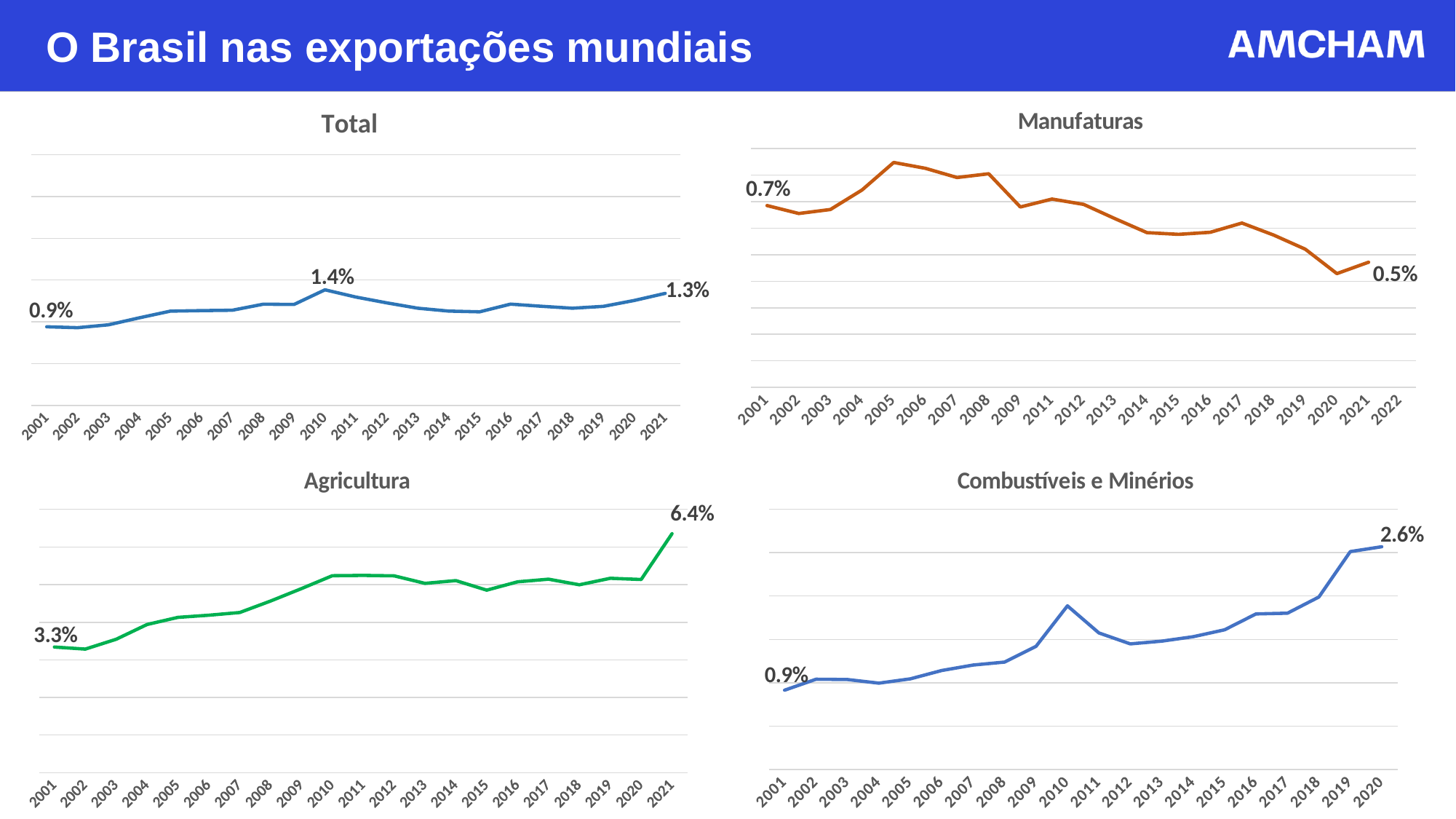
In the Manufaturas chart, does the value overall rise or fall from 2001 to 2021? fall In the Manufaturas chart, which year has the lowest value? 2020 In the Combustíveis e Minérios chart, which is larger, the 2001 value or the 2020 value? 2020 In the Agricultura chart, what is the difference between the 2021 value and the 2001 value? 3.1 percentage points In the Total chart, what value is labelled for 2001? 0.9% What kind of chart is the Agricultura chart? line chart In the Manufaturas chart, what value is labelled at the end of the line in 2021? 0.5% In the Total chart, which year has the highest value? 2010 In the Total chart, what value is labelled for 2010? 1.4% How many data points does the Combustíveis e Minérios chart plot along the x axis? 20 In the Combustíveis e Minérios chart, what value is labelled for 2020? 2.6% In the Agricultura chart, what value is labelled for 2021? 6.4%